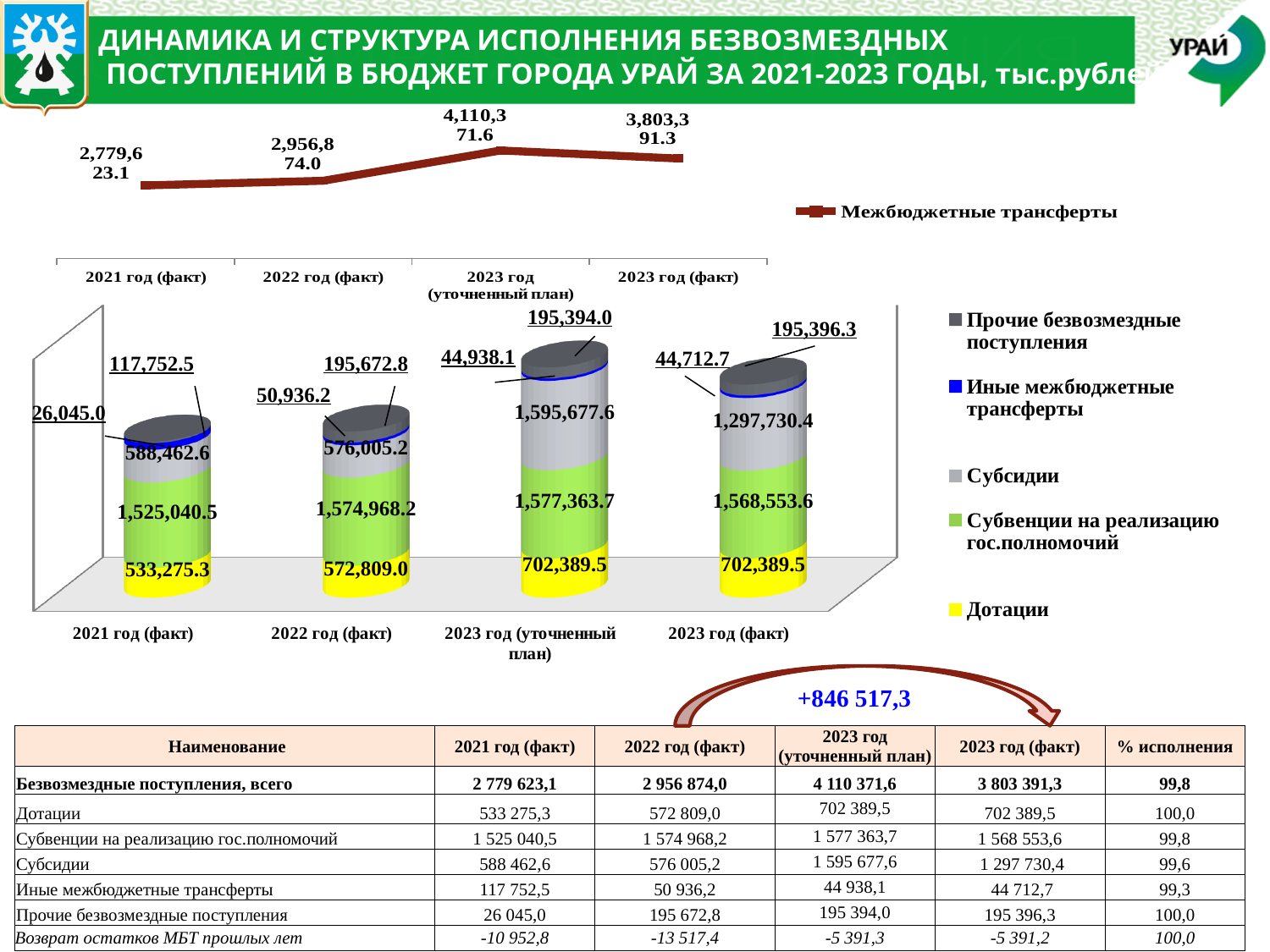
How many series does the legend of the stacked bar chart list? 5 In the stacked bar chart, what is the value of Дотации for 2021 год (факт)? 533,275.3 In the stacked bar chart, which is larger: Субвенции на реализацию гос.полномочий for 2022 год (факт) or for 2023 год (факт)? 2022 год (факт) In the top line chart (Межбюджетные трансферты), which period has the highest value? 2023 год (уточненный план) In the stacked bar chart, what is the value of Прочие безвозмездные поступления for 2022 год (факт)? 195,672.8 In the stacked bar chart, what is the value of Субсидии for 2023 год (факт)? 1,297,730.4 In the stacked bar chart, which year has the highest value for Иные межбюджетные трансферты? 2021 год (факт) In the stacked bar chart, which year has the lowest value for Прочие безвозмездные поступления? 2021 год (факт) In the top line chart (Межбюджетные трансферты), what is the value labelled for 2023 год (уточненный план)? 4,110,371.6 In the stacked bar chart, what is the value of Иные межбюджетные трансферты for 2023 год (уточненный план)? 44,938.1 What kind of chart is the top chart labelled Межбюджетные трансферты? line chart In the stacked bar chart, what is the difference between Субсидии for 2023 год (уточненный план) and 2023 год (факт)? 297,947.2